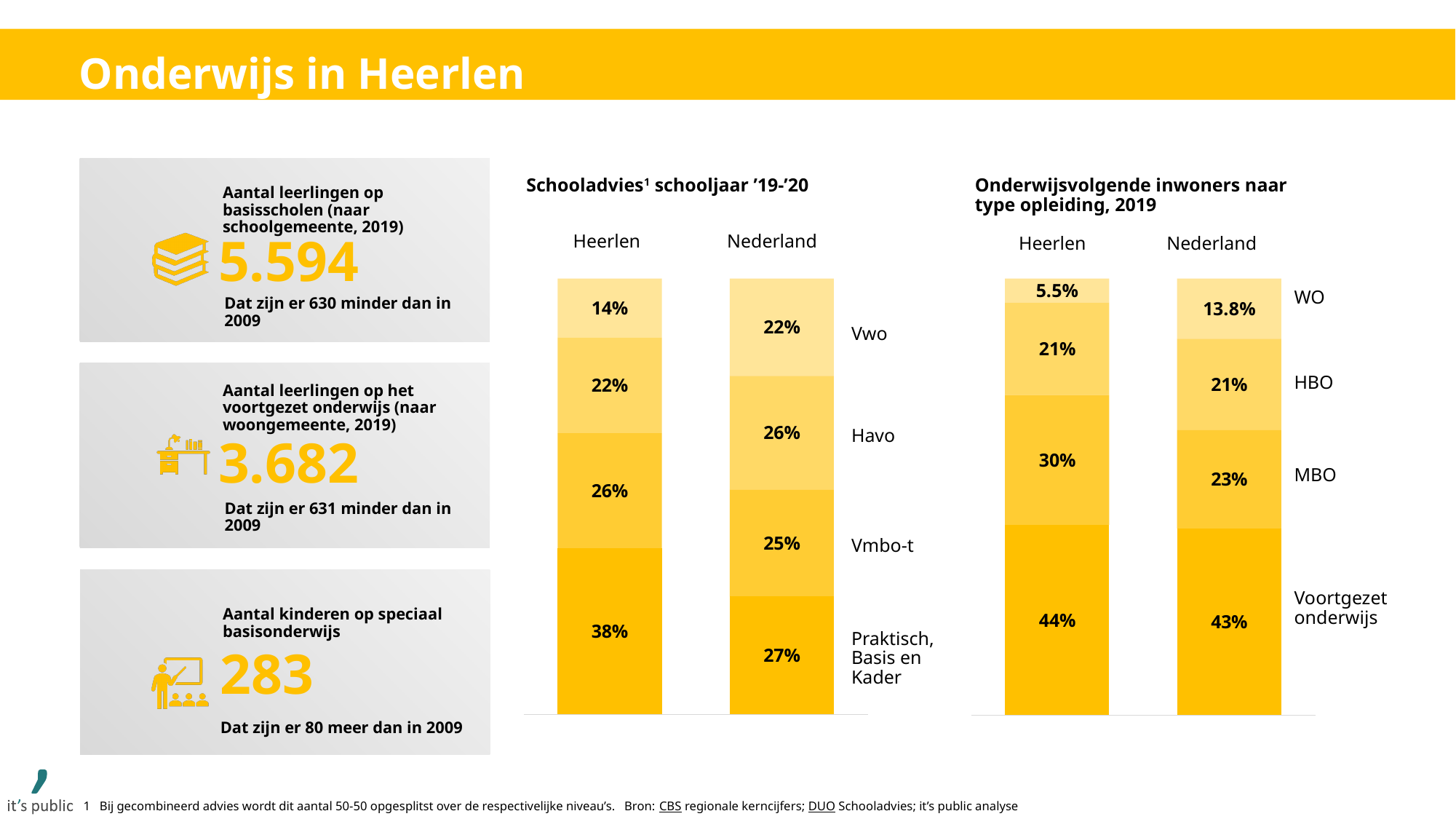
In the 'Schooladvies schooljaar '19-'20' chart, what is the Praktisch, Basis en Kader share for Nederland? 27% In the 'Schooladvies schooljaar '19-'20' chart, what is the difference between the Vwo share for Nederland and for Heerlen? 8% In the 'Schooladvies schooljaar '19-'20' chart, what is the Vwo share for Heerlen? 14% In the 'Schooladvies schooljaar '19-'20' chart, which is larger: the Havo share for Heerlen or for Nederland? Nederland In the 'Onderwijsvolgende inwoners naar type opleiding, 2019' chart, what is the WO share for Heerlen? 5.5% What kind of chart is 'Onderwijsvolgende inwoners naar type opleiding, 2019'? Stacked bar chart In the 'Onderwijsvolgende inwoners naar type opleiding, 2019' chart, what is the MBO share for Nederland? 23% In the 'Onderwijsvolgende inwoners naar type opleiding, 2019' chart, which segment is the smallest in the Heerlen bar? WO In the 'Schooladvies schooljaar '19-'20' chart, how many segments does each bar have? 4 In the 'Onderwijsvolgende inwoners naar type opleiding, 2019' chart, which is larger: the WO share for Heerlen or for Nederland? Nederland In the 'Onderwijsvolgende inwoners naar type opleiding, 2019' chart, what is the difference between the MBO share for Heerlen and for Nederland? 7% In the 'Schooladvies schooljaar '19-'20' chart, which segment is the largest in the Heerlen bar? Praktisch, Basis en Kader